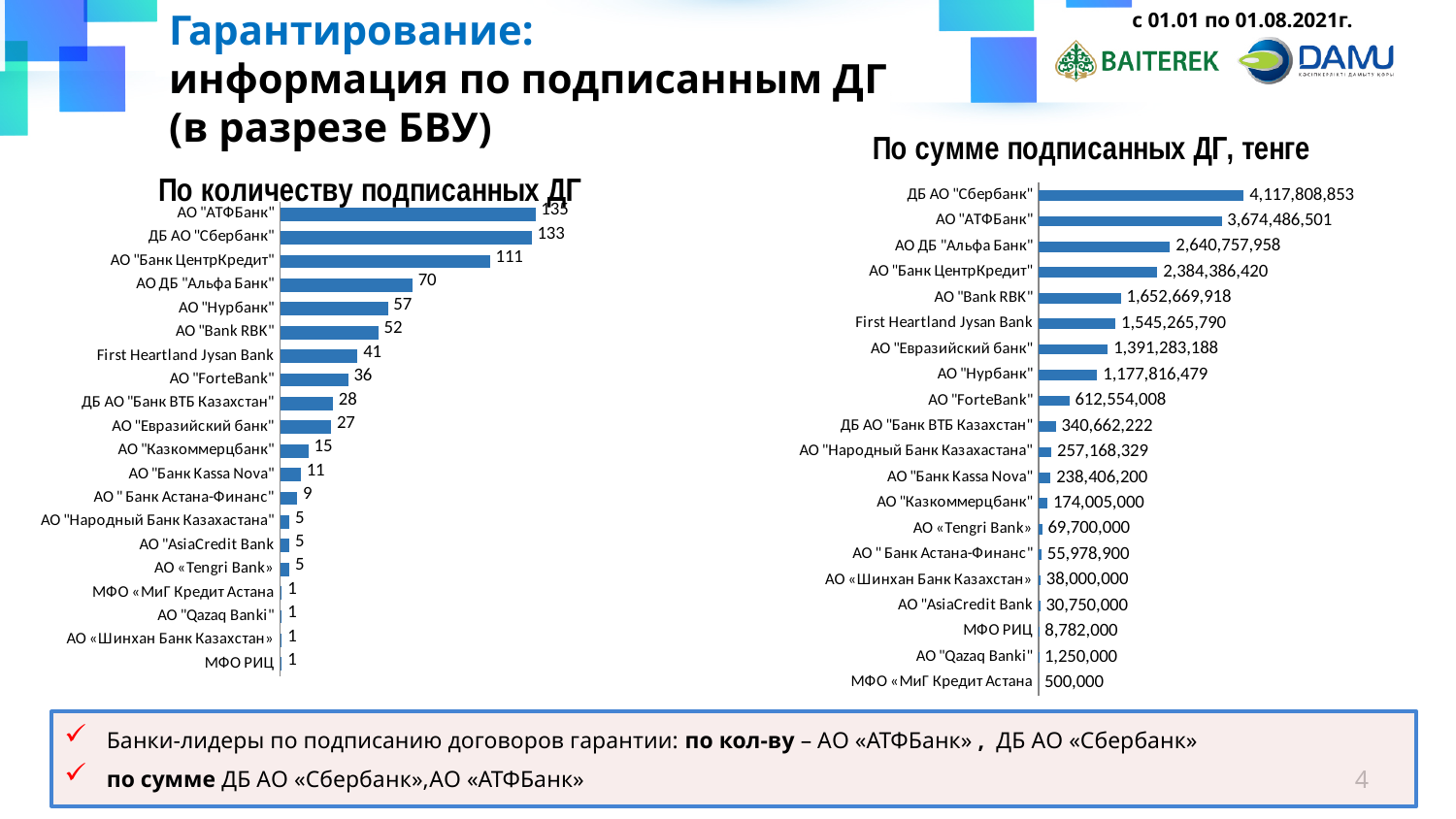
What type of chart is "По сумме подписанных ДГ, тенге"? Bar chart In the chart "По сумме подписанных ДГ, тенге", what is the value for АО "ForteBank"? 612,554,008 In the chart "По количеству подписанных ДГ", which is larger: АО "Нурбанк" or АО "ForteBank"? АО "Нурбанк" In the chart "По количеству подписанных ДГ", what is the value for АО "АТФБанк"? 135 In the chart "По количеству подписанных ДГ", which category has the highest value? АО "АТФБанк" In the chart "По сумме подписанных ДГ, тенге", what is the value for ДБ АО "Сбербанк"? 4,117,808,853 In the chart "По количеству подписанных ДГ", what is the value for АО "Bank RBK"? 52 In the chart "По количеству подписанных ДГ", what is the difference between АО "АТФБанк" and ДБ АО "Сбербанк"? 2 In the chart "По сумме подписанных ДГ, тенге", what is the difference between ДБ АО "Сбербанк" and АО "АТФБанк"? 443,322,352 In the chart "По количеству подписанных ДГ", how many categories are shown? 20 In the chart "По сумме подписанных ДГ, тенге", which is larger: АО ДБ "Альфа Банк" or АО "Банк ЦентрКредит"? АО ДБ "Альфа Банк" In the chart "По сумме подписанных ДГ, тенге", which category has the lowest value? МФО «МиГ Кредит Астана